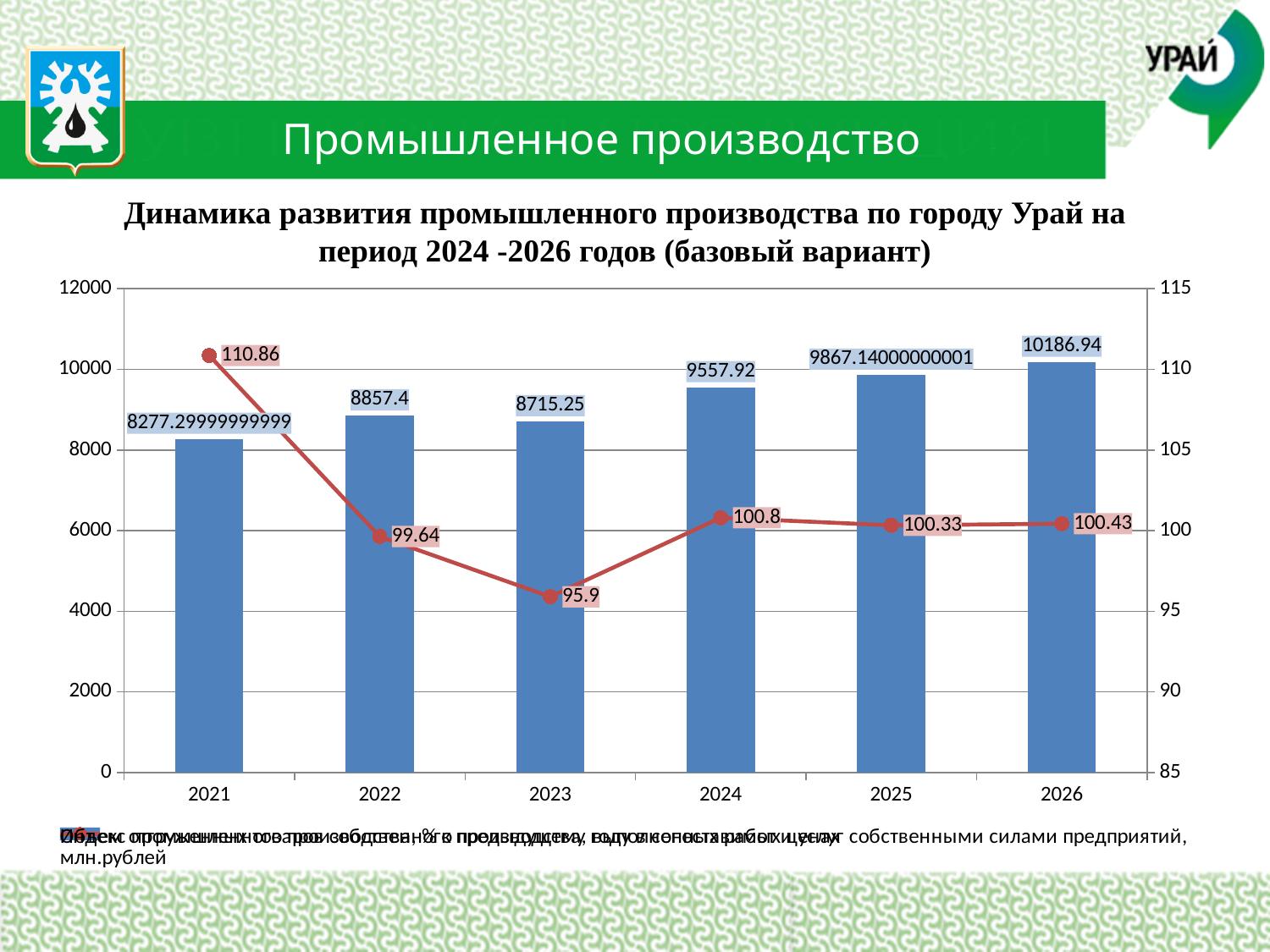
Which bar is larger, 2022 or 2023? 2022 Which year has the lowest bar value? 2021 What is the difference between the line values for 2021 and 2022? 11.22 How many years are shown on the x axis? 6 Which year has the lowest line (index) value? 2023 Do the bar values rise or fall from 2024 to 2026? rise What is the bar value for 2024? 9557.92 What is the line value for 2021? 110.86 Is the bar value for 2021 greater or less than 8000? greater What is the line (index) value for 2023? 95.9 What kind of chart is this? Combined bar and line chart Which year has the highest bar value? 2026